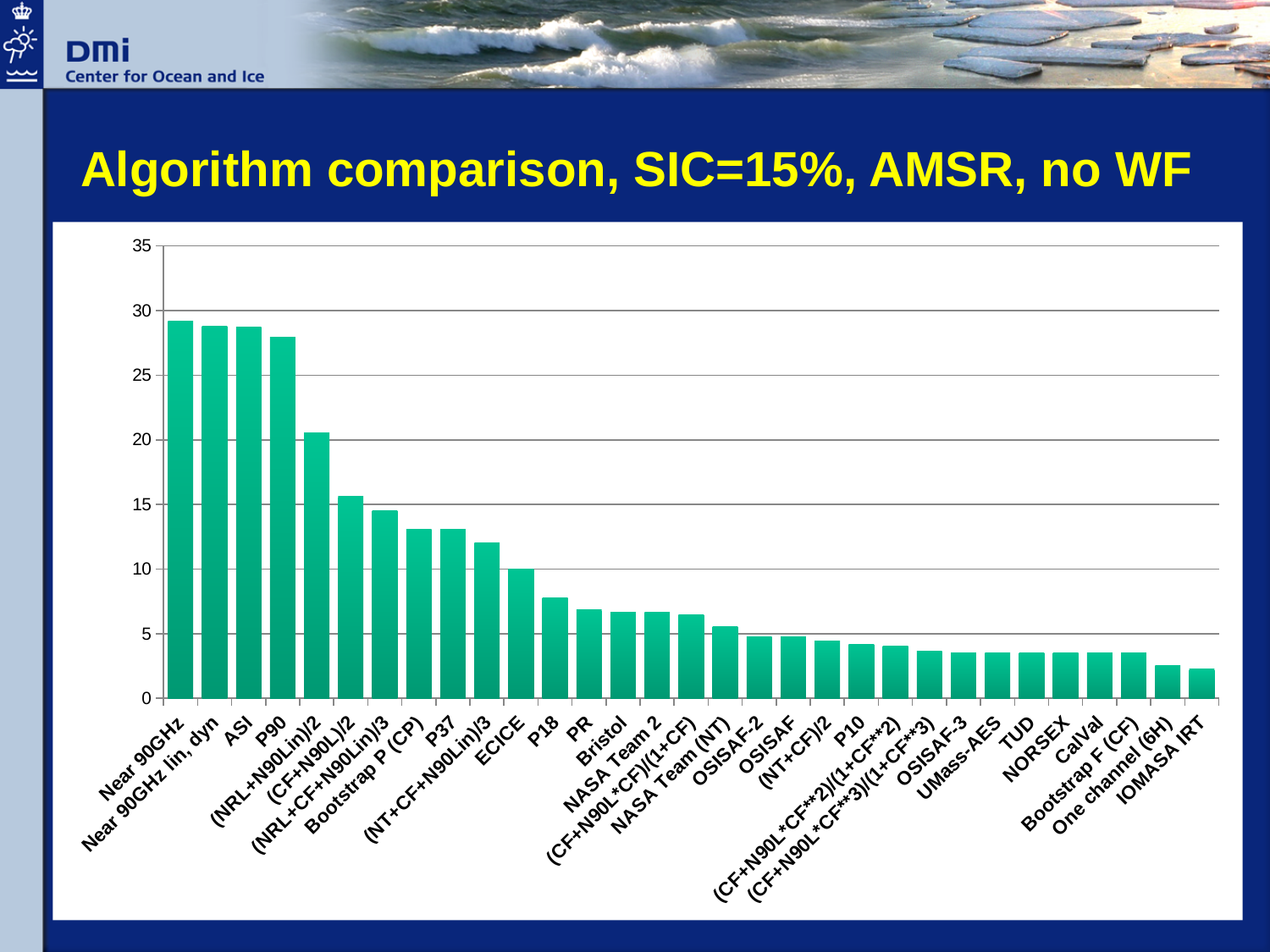
Is the value for TUD greater or less than 5? less Is the value for P18 greater or less than 10? less Which has the larger value, (NRL+N90Lin)/2 or NASA Team (NT)? (NRL+N90Lin)/2 Which has the larger value, ASI or ECICE? ASI What is the title of the chart? Algorithm comparison, SIC=15%, AMSR, no WF Do the bar values rise or fall from left to right along the x axis? fall Is the value for Bootstrap P (CP) greater or less than 10? greater How many algorithms (bars) are plotted in the chart? 31 What kind of chart is shown on the slide? bar chart